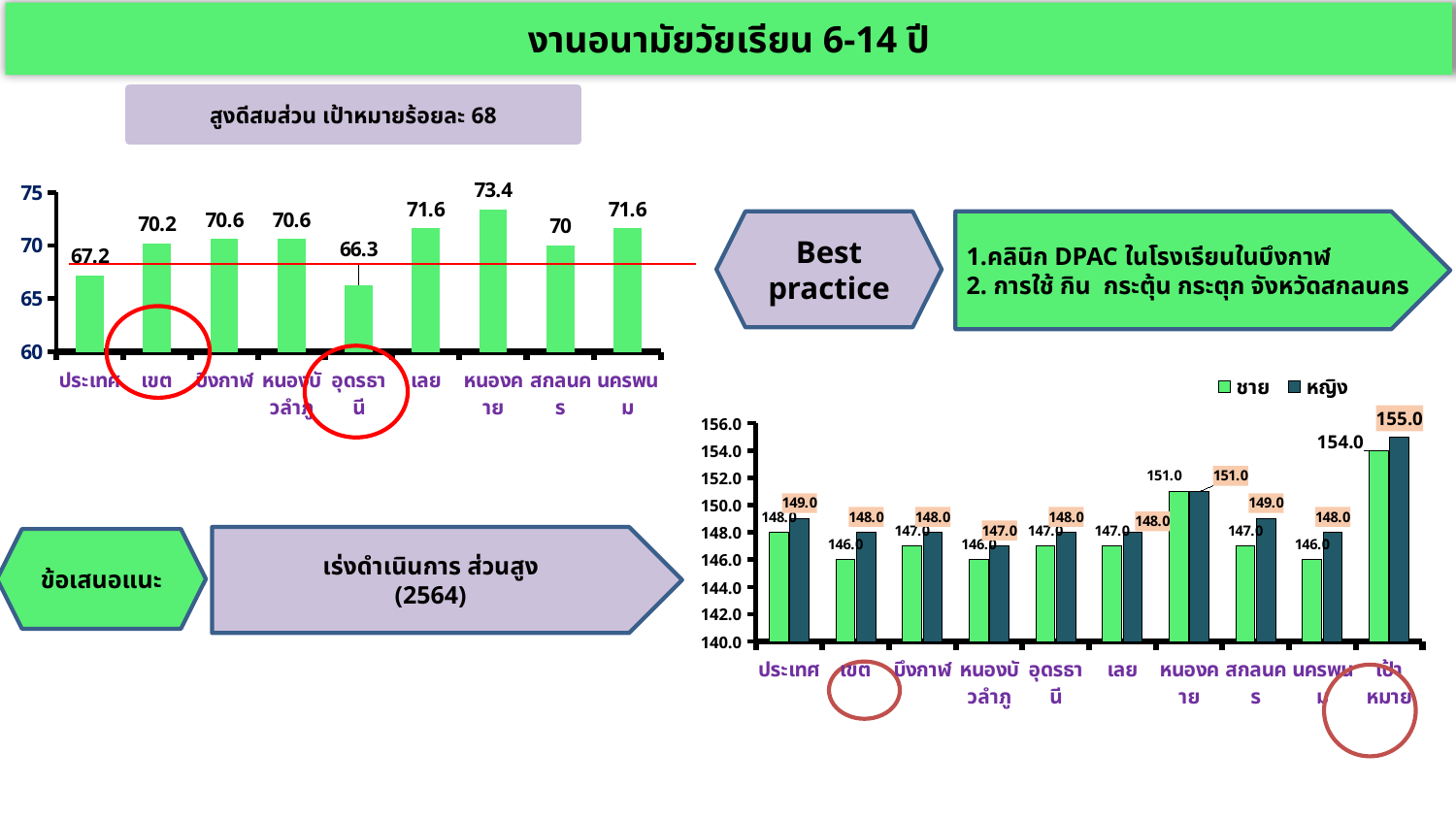
In the left chart (สูงดีสมส่วน), which category has the lowest value? อุดรธานี In the left chart (สูงดีสมส่วน), what is the value for อุดรธานี? 66.3 In the right chart (ชาย/หญิง), how many series does the legend list? 2 In the right chart (ชาย/หญิง), what is the ชาย value for หนองคาย? 151.0 In the left chart (สูงดีสมส่วน), what is the value for หนองคาย? 73.4 In the left chart (สูงดีสมส่วน), how many categories are shown on the x axis? 9 In the left chart (สูงดีสมส่วน), which category has the highest value? หนองคาย In the right chart (ชาย/หญิง), which is larger for สกลนคร, the ชาย value or the หญิง value? หญิง What kind of chart is the right chart (ชาย/หญิง)? bar chart In the right chart (ชาย/หญิง), what is the หญิง value for เป้าหมาย? 155.0 In the left chart (สูงดีสมส่วน), is the value for เขต greater or less than 70? greater In the left chart (สูงดีสมส่วน), what is the difference between the values for หนองคาย and ประเทศ? 6.2